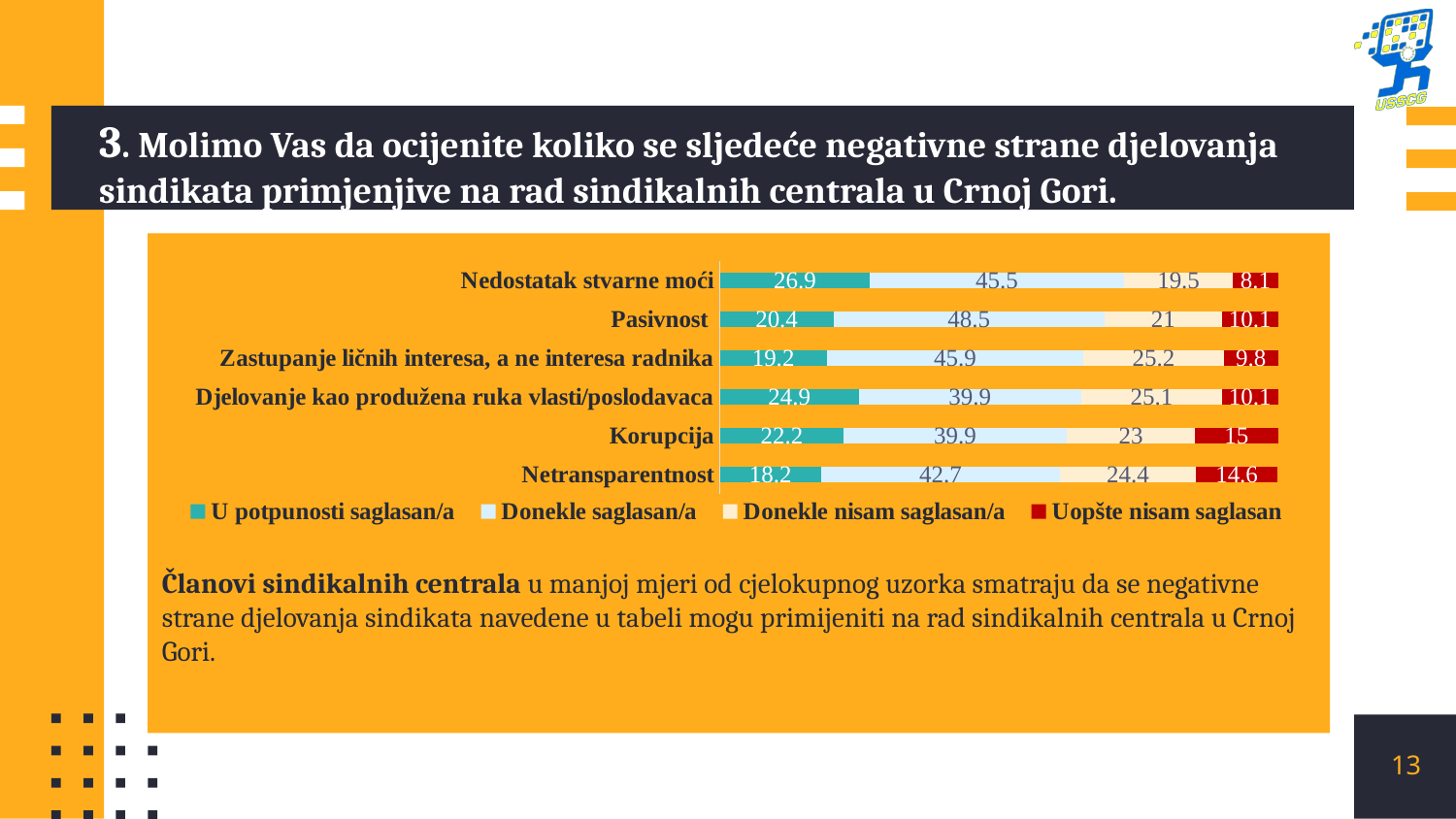
What is the value of 'Uopšte nisam saglasan' for 'Korupcija'? 15 What is the total of the stacked bar for 'Nedostatak stvarne moći'? 100 What is the value of 'U potpunosti saglasan/a' for 'Nedostatak stvarne moći'? 26.9 How many categories are shown in the chart? 6 What is the value of 'Donekle saglasan/a' for 'Pasivnost'? 48.5 What is the value of 'Donekle nisam saglasan/a' for 'Netransparentnost'? 24.4 Which is larger: the 'U potpunosti saglasan/a' value for 'Djelovanje kao produžena ruka vlasti/poslodavaca' or for 'Zastupanje ličnih interesa, a ne interesa radnika'? Djelovanje kao produžena ruka vlasti/poslodavaca What is the difference between the 'Donekle saglasan/a' values for 'Pasivnost' and 'Korupcija'? 8.6 Which category has the lowest value for 'Uopšte nisam saglasan'? Nedostatak stvarne moći Which category has the highest value for 'U potpunosti saglasan/a'? Nedostatak stvarne moći What type of chart is shown on the slide? stacked bar chart How many series does the legend list? 4